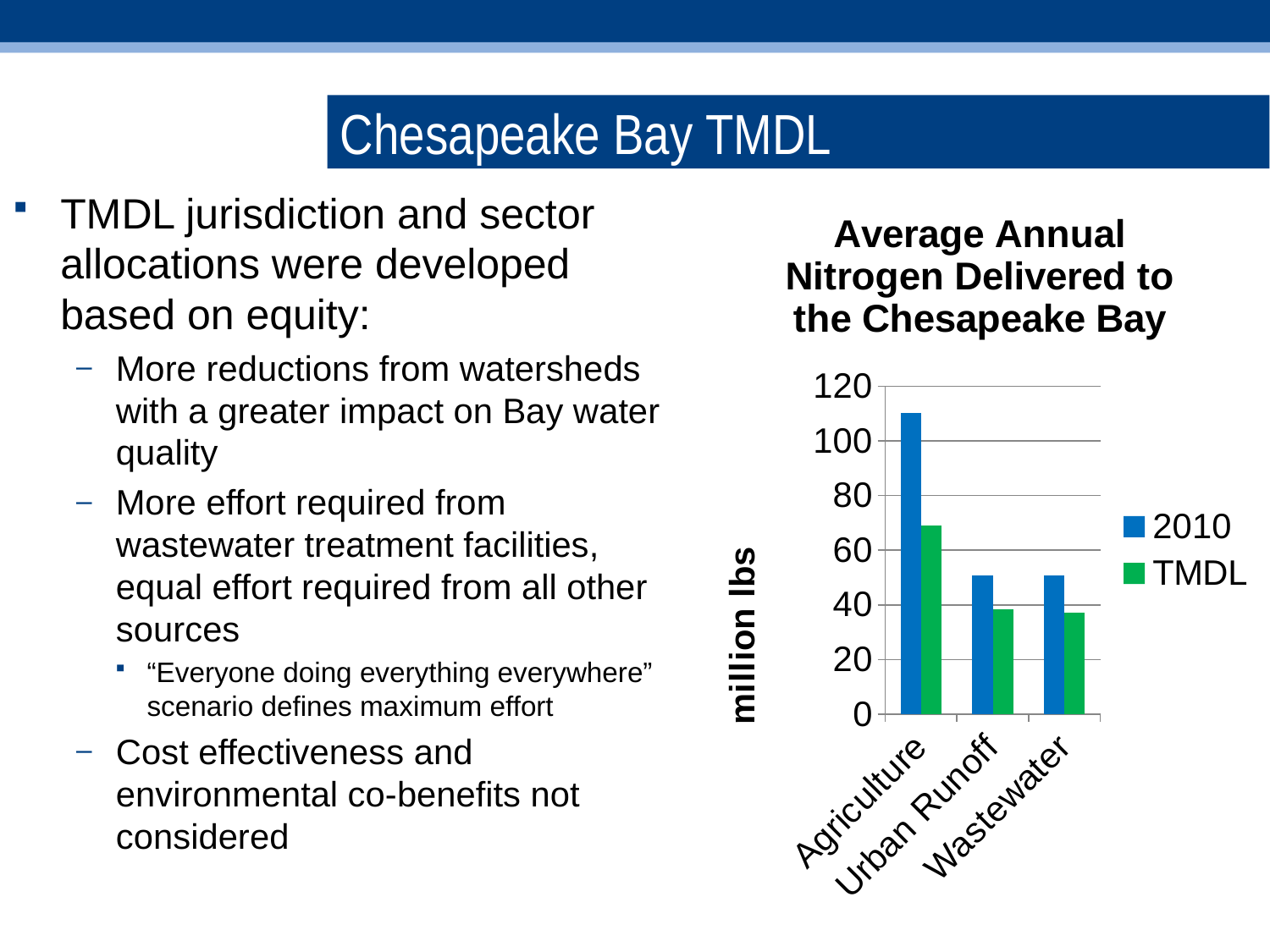
What is the unit shown on the y axis of the chart? million lbs How many series does the chart legend list? 2 How many categories are shown on the x axis of the chart? 3 For Agriculture, which is larger, the 2010 value or the TMDL value? 2010 Which category has the highest TMDL value? Agriculture What kind of chart is shown on the slide? bar chart Is the TMDL value for Agriculture greater or less than 80? less Which category has the highest 2010 value? Agriculture Is the 2010 value for Urban Runoff greater or less than 60? less What is the title of the chart? Average Annual Nitrogen Delivered to the Chesapeake Bay Is the 2010 value for Wastewater greater or less than 40? greater